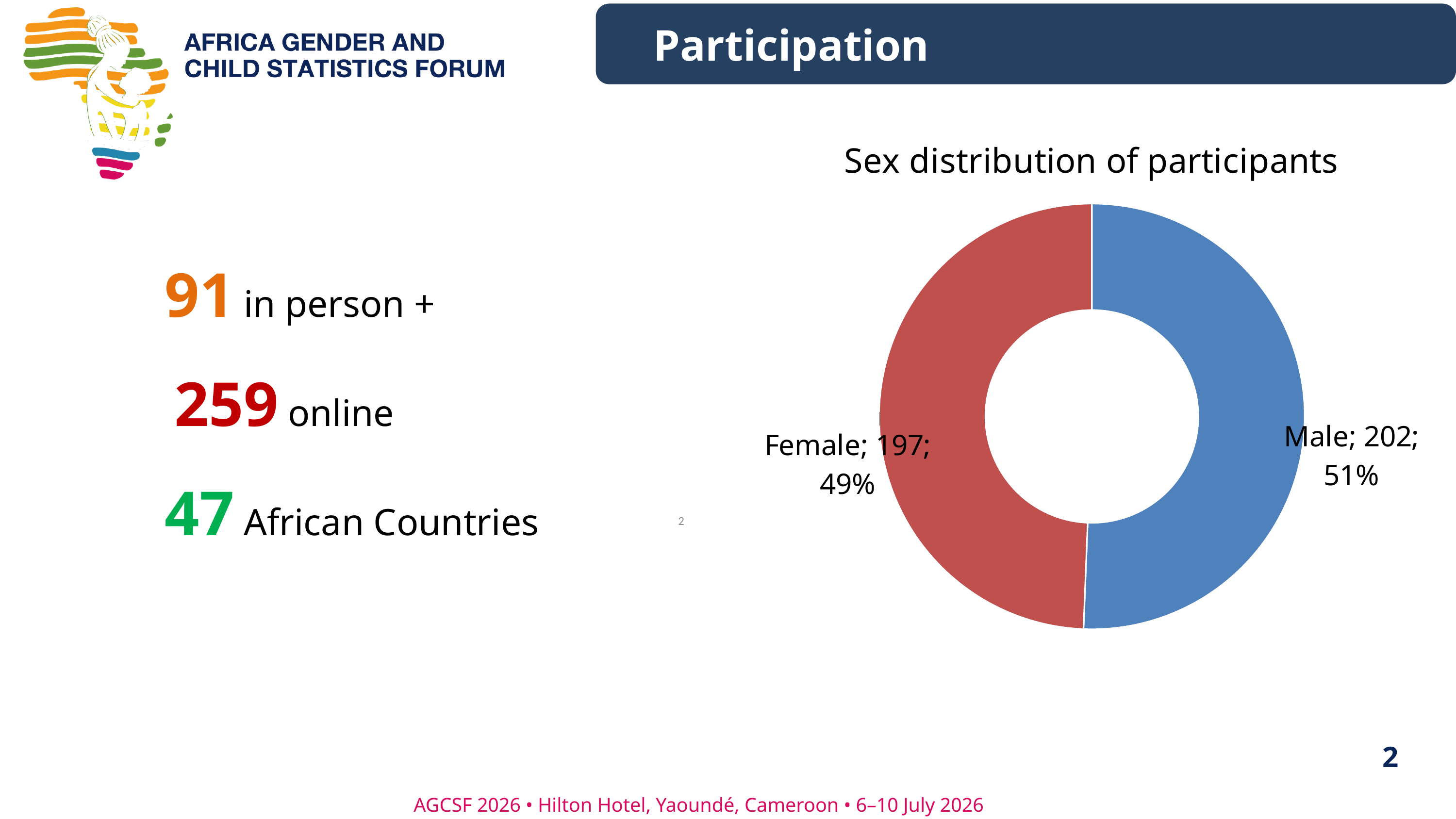
What share of participants is Male? 51% What share of participants is Female? 49% How many participants are Male according to the chart? 202 How many categories does the chart show? 2 Which colour represents the Female slice in the chart? Red What is the title of the chart? Sex distribution of participants What kind of chart is shown on the slide? Pie chart (doughnut) What is the difference between the number of Male and Female participants? 5 What is the total number of participants shown in the chart? 399 How many participants are Female according to the chart? 197